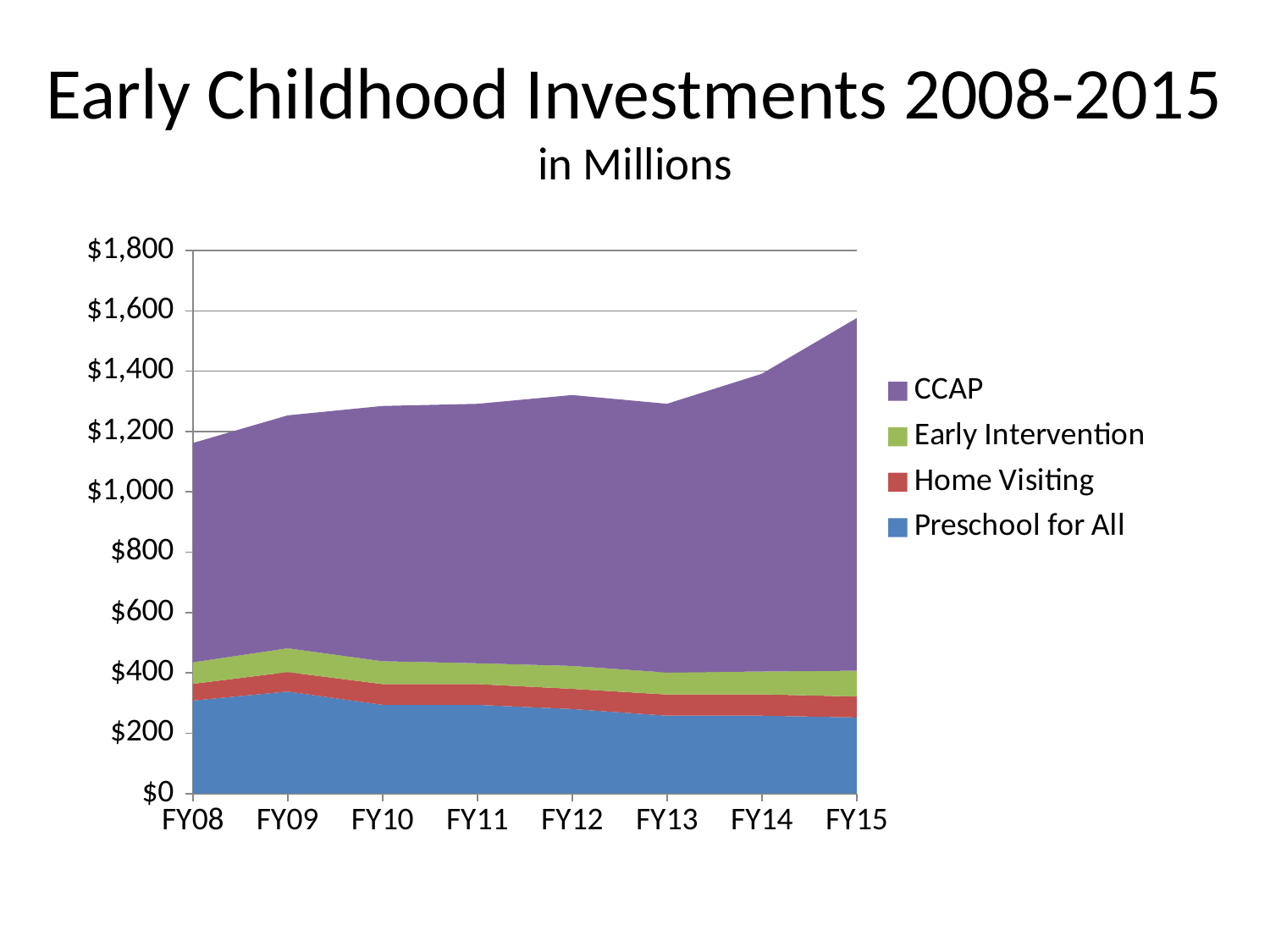
How many series does the legend list? 4 What unit does the subtitle say the values are in? Millions How many fiscal years are shown on the x axis? 8 What kind of chart is shown on the slide? Stacked area chart In FY15, which is larger: CCAP or Preschool for All? CCAP Is the value for Preschool for All in FY15 greater or less than $400? less Is the total investment for FY08 greater or less than $1,400? less Is the value for Preschool for All in FY09 greater or less than $200? greater Does the total investment rise or fall from FY08 to FY15? Rise Which fiscal year has the highest total investment? FY15 Which series is listed first in the legend? CCAP